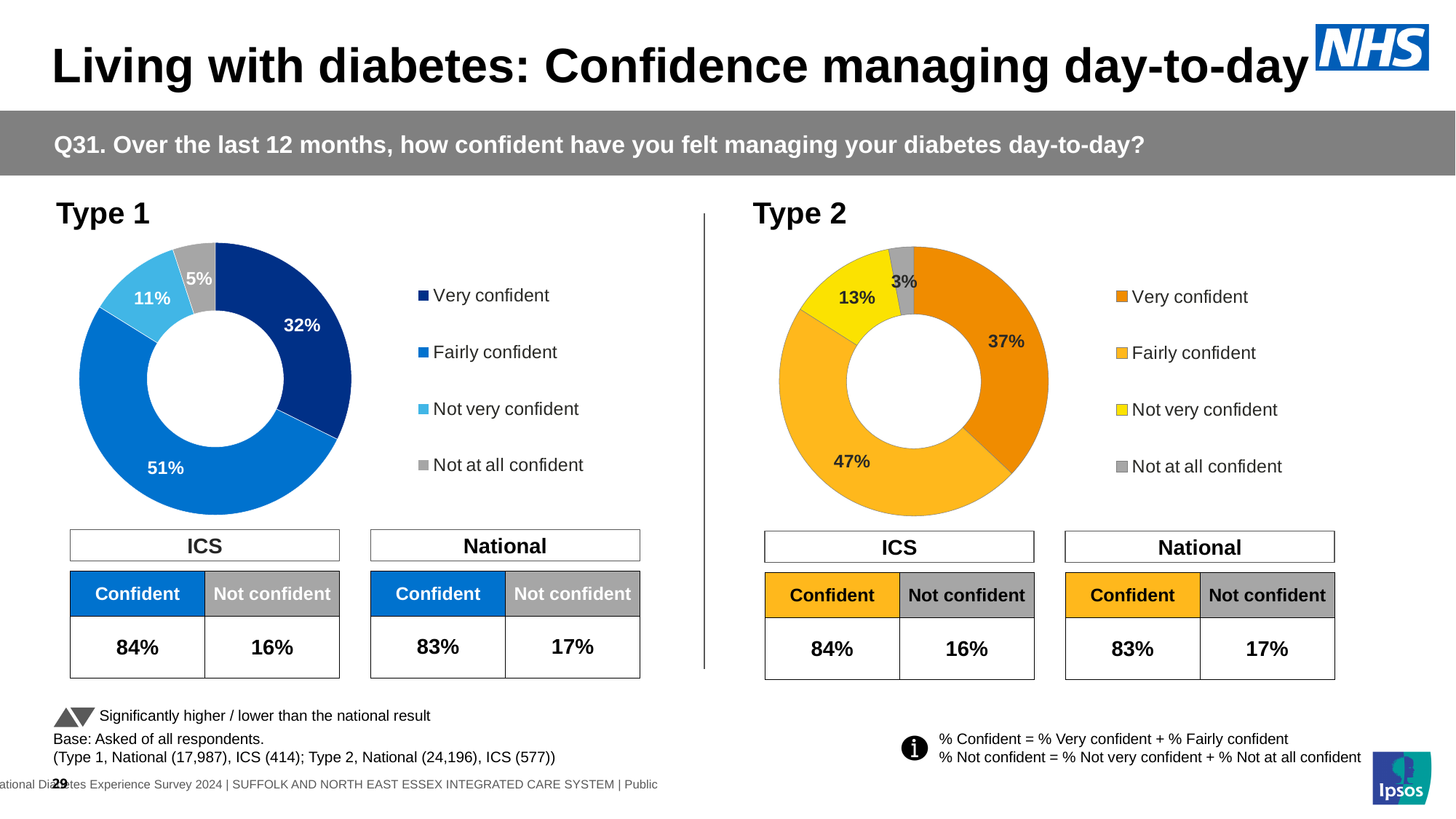
What kind of chart is used for Type 1? Doughnut chart In the Type 1 chart, what percentage of respondents were Fairly confident? 51% In the Type 1 chart, which category has the largest share? Fairly confident In the Type 2 chart, what is the difference between the Fairly confident and Very confident shares? 10 percentage points In the Type 2 chart, which category has the smallest share? Not at all confident How many categories does the Type 2 chart show? 4 In the Type 1 chart, what is the combined share of Very confident and Fairly confident? 83% In the Type 1 chart, what percentage of respondents were Very confident? 32% In the Type 1 chart, which is larger: the Not very confident share or the Not at all confident share? Not very confident In the Type 2 chart, what colour is the Very confident segment? Orange In the Type 2 chart, what percentage of respondents were Not at all confident? 3% In the Type 2 chart, what percentage of respondents were Not very confident? 13%